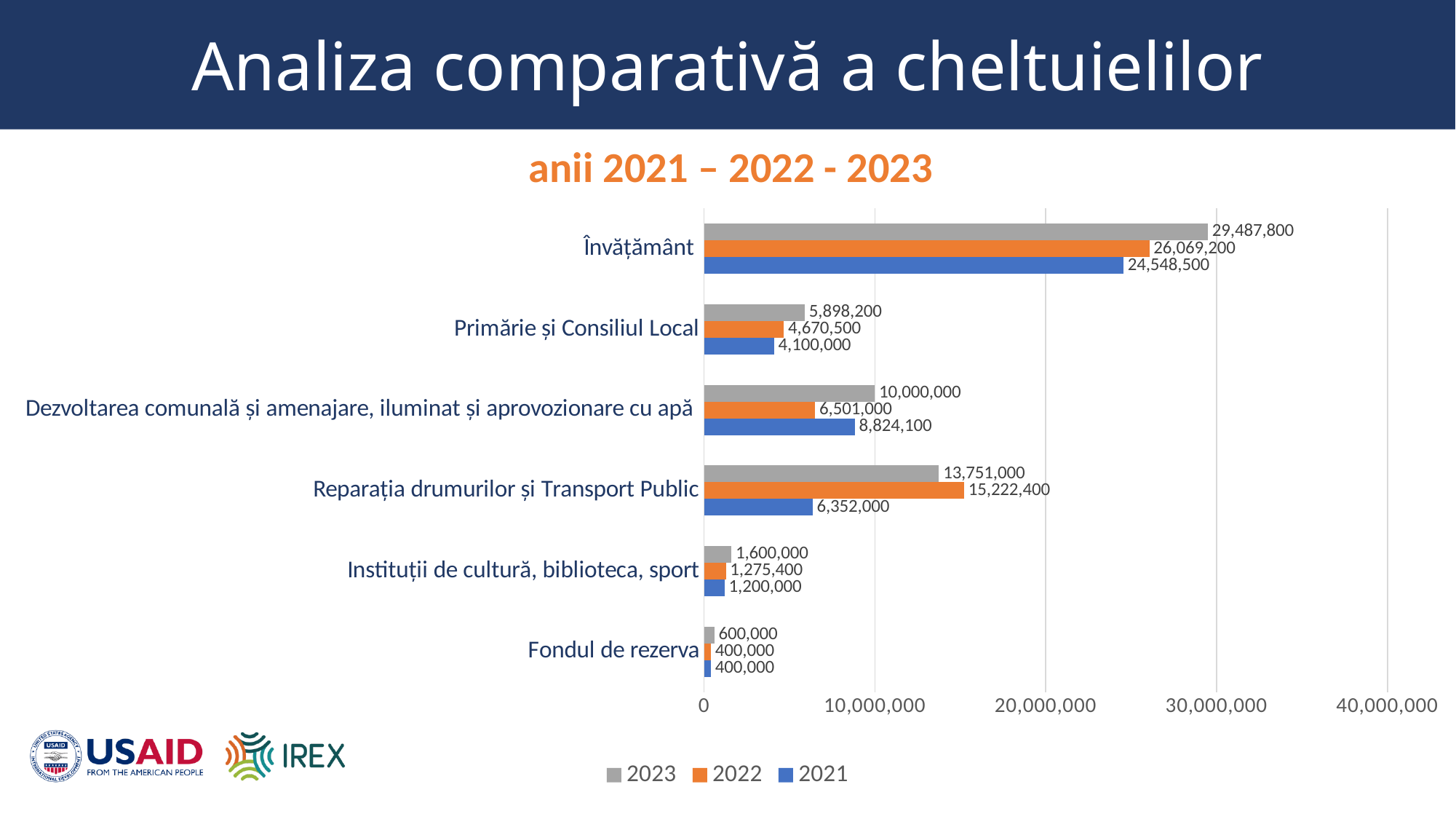
How many series does the legend list? 3 How many categories are shown on the chart? 6 What is the 2022 value for Reparația drumurilor și Transport Public? 15,222,400 What is the difference between the 2023 and 2022 values for Primărie și Consiliul Local? 1,227,700 What is the 2023 value for Dezvoltarea comunală și amenajare, iluminat și aprovozionare cu apă? 10,000,000 What is the value for Învățământ in 2023? 29,487,800 Which category has the highest value in 2021? Învățământ What is the difference between the 2023 and 2021 values for Învățământ? 4,939,300 Which category has the lowest value in 2023? Fondul de rezerva What kind of chart is shown on the slide? bar chart For Reparația drumurilor și Transport Public, which year has the larger value, 2022 or 2023? 2022 Is the 2022 value for Învățământ greater or less than 20,000,000? greater